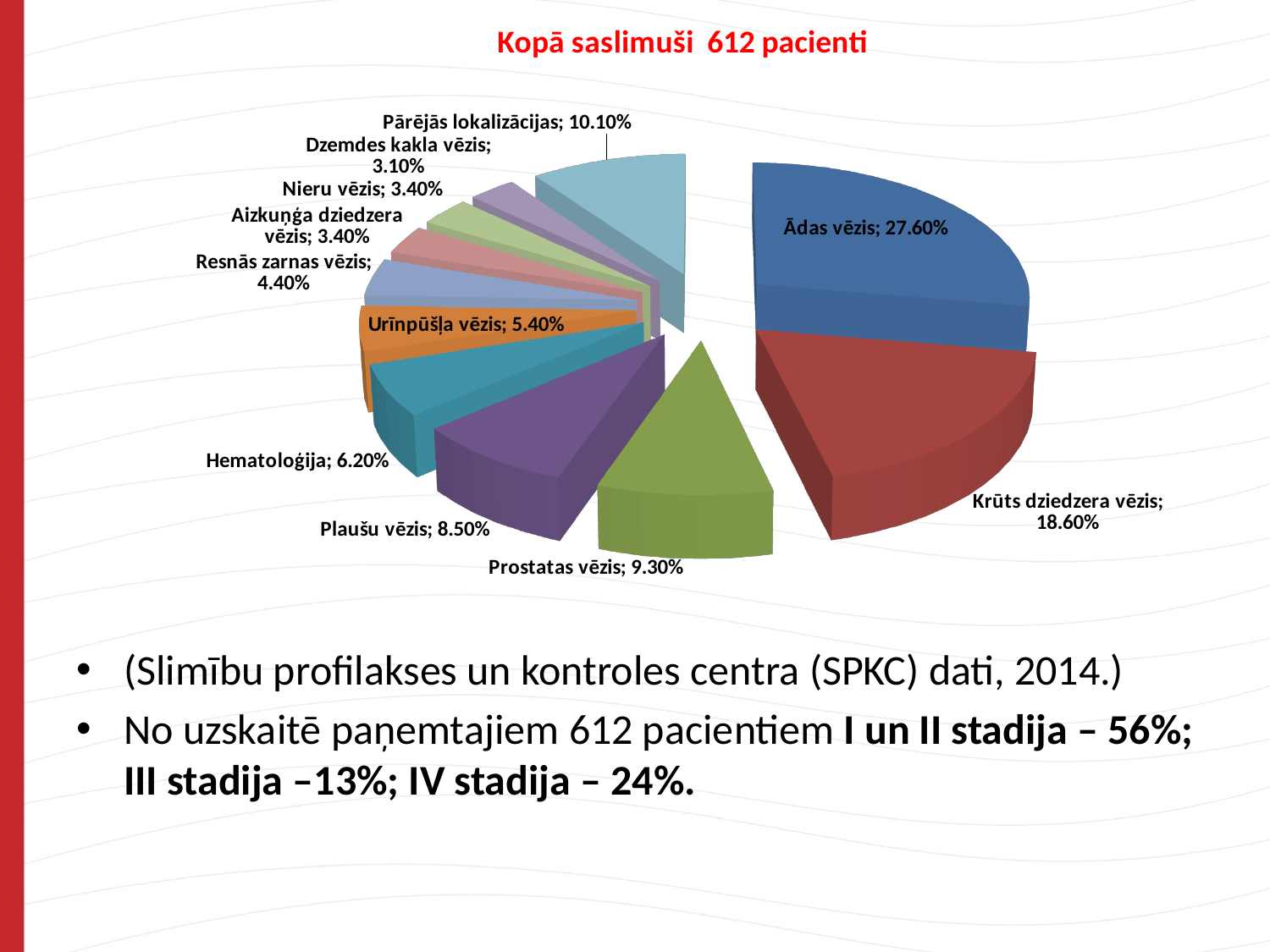
What percentage is shown for Ādas vēzis? 27.60% What percentage is shown for Krūts dziedzera vēzis? 18.60% How many slices does the pie chart have? 11 What percentage is shown for Urīnpūšļa vēzis? 5.40% What is the title of the chart? Kopā saslimuši 612 pacienti Which category has the largest share of the pie? Ādas vēzis What is the share shown for Pārējās lokalizācijas? 10.10% Which is larger, the share for Plaušu vēzis or the share for Hematoloģija? Plaušu vēzis What kind of chart is shown on the slide? pie chart What is the difference between the shares of Ādas vēzis and Krūts dziedzera vēzis? 9.00% What percentage is shown for Prostatas vēzis? 9.30% Which category has the smallest share of the pie? Dzemdes kakla vēzis